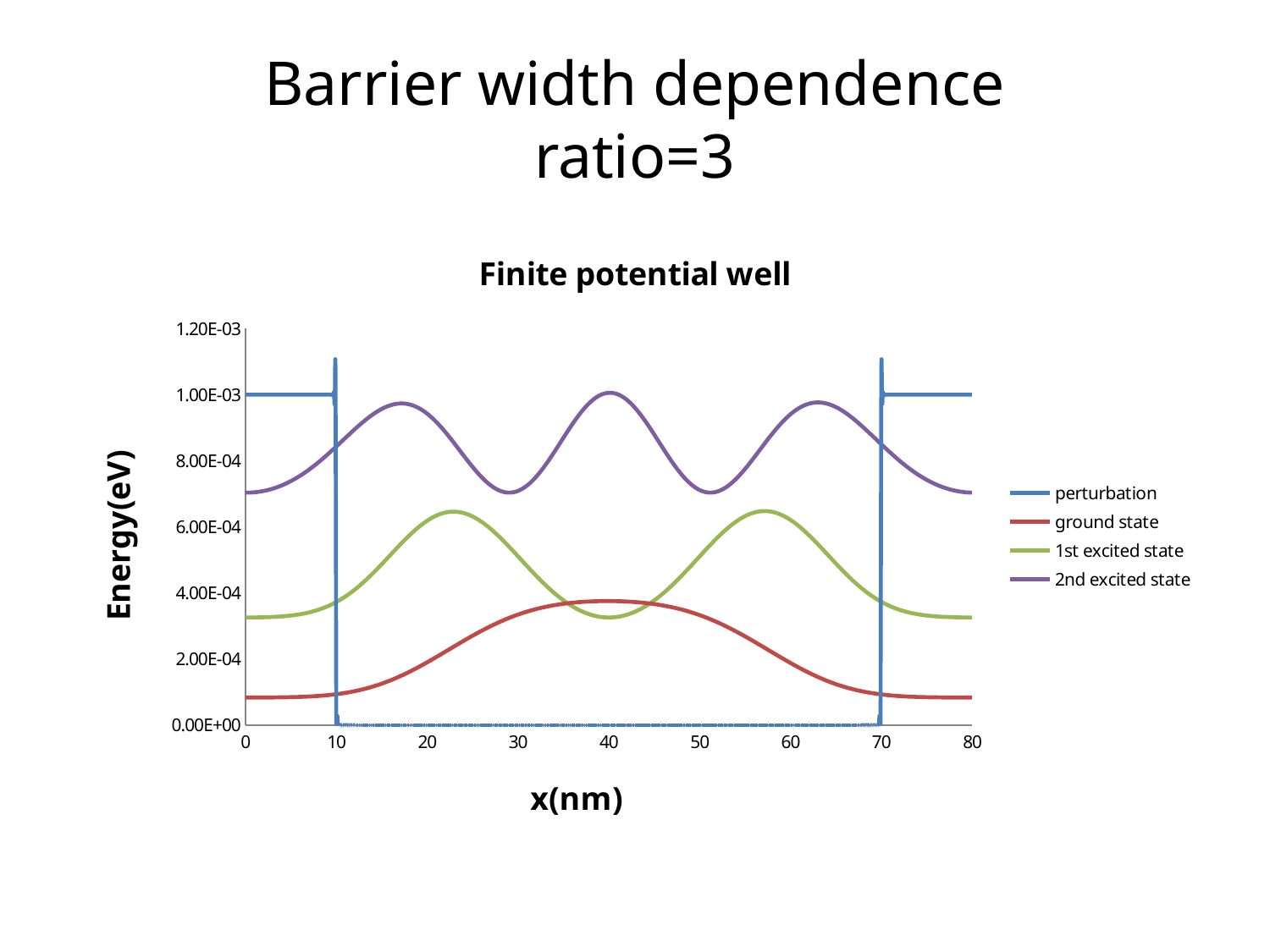
What is the label of the vertical axis? Energy(eV) How many series does the legend list? 4 What is the value of the perturbation series at x = 40 nm? 0.00E+00 Is the value of the 2nd excited state at x = 17 nm greater or less than 8.00E-04? greater Is the value of the ground state at x = 40 nm greater or less than 4.00E-04? less What is the value of the perturbation series at x = 5 nm? 1.00E-03 What is the title of the chart? Finite potential well Among the ground state, 1st excited state and 2nd excited state curves, which reaches the highest energy? 2nd excited state Is the peak value of the 1st excited state near x = 23 nm greater or less than 6.00E-04? greater At x = 40 nm, which is higher: the ground state or the 1st excited state? ground state What kind of chart is shown on the slide? line chart